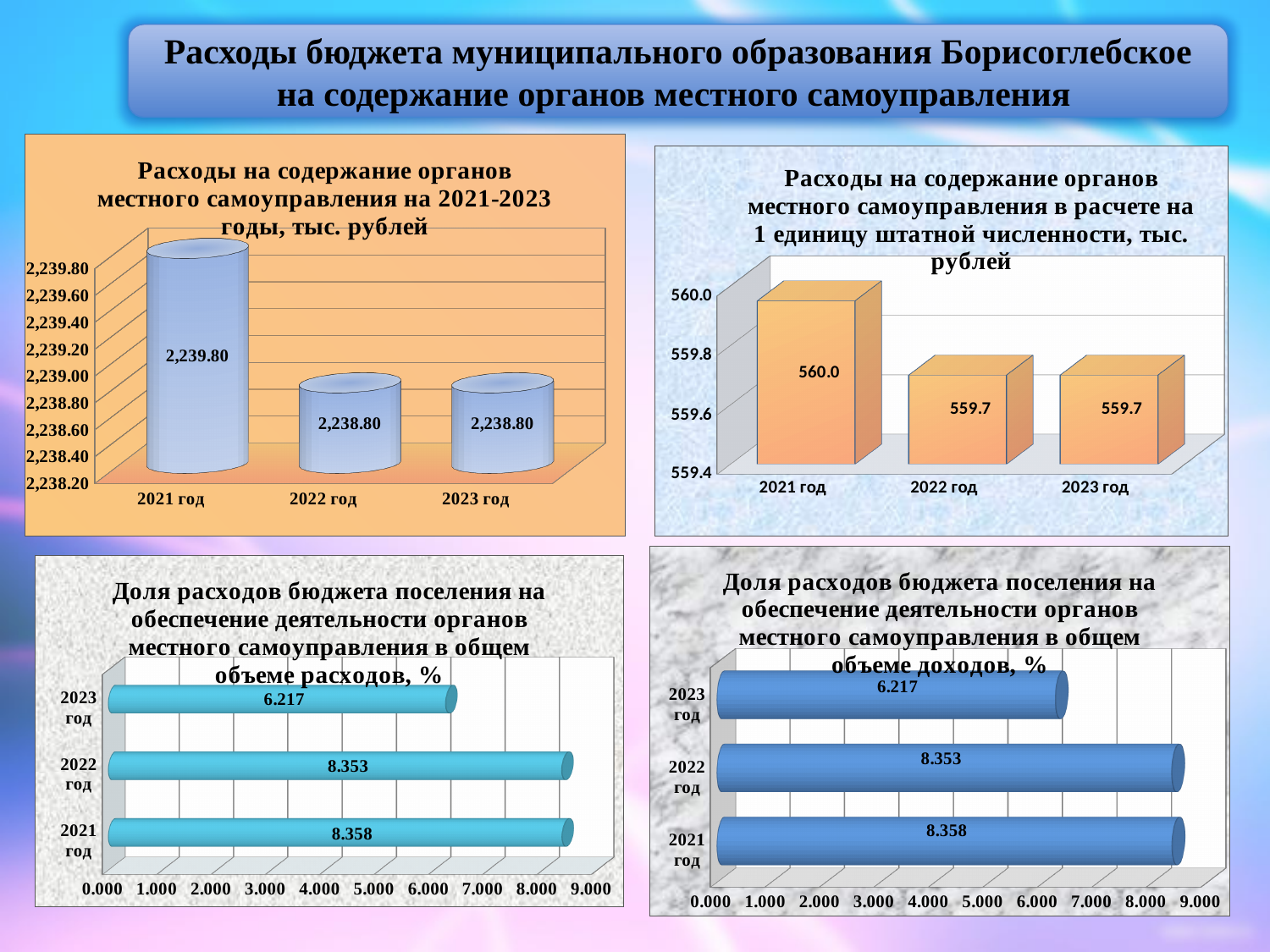
In the bottom-left chart (Доля расходов ... в общем объеме расходов, %), what is the value for 2023 год? 6.217 In the top-right chart (Расходы в расчете на 1 единицу штатной численности), what is the value for 2022 год? 559.7 In the top-left chart (Расходы на содержание органов местного самоуправления на 2021-2023 годы), what is the value for 2023 год? 2,238.80 In the top-left chart (Расходы на содержание органов местного самоуправления на 2021-2023 годы), what is the difference between the values for 2021 год and 2022 год? 1.00 In the top-right chart (Расходы в расчете на 1 единицу штатной численности), what is the difference between the values for 2021 год and 2023 год? 0.3 In the bottom-right chart (Доля расходов ... в общем объеме доходов, %), is the value for 2023 год greater or less than 7.000? less In the top-right chart (Расходы в расчете на 1 единицу штатной численности), what is the value for 2021 год? 560.0 In the bottom-left chart (Доля расходов ... в общем объеме расходов, %), which year has the lowest value? 2023 год How many years are shown in the bottom-right chart (Доля расходов ... в общем объеме доходов, %)? 3 In the top-left chart (Расходы на содержание органов местного самоуправления на 2021-2023 годы), which year has the highest value? 2021 год In the top-left chart (Расходы на содержание органов местного самоуправления на 2021-2023 годы), what is the value for 2021 год? 2,239.80 In the bottom-right chart (Доля расходов ... в общем объеме доходов, %), what is the value for 2021 год? 8.358